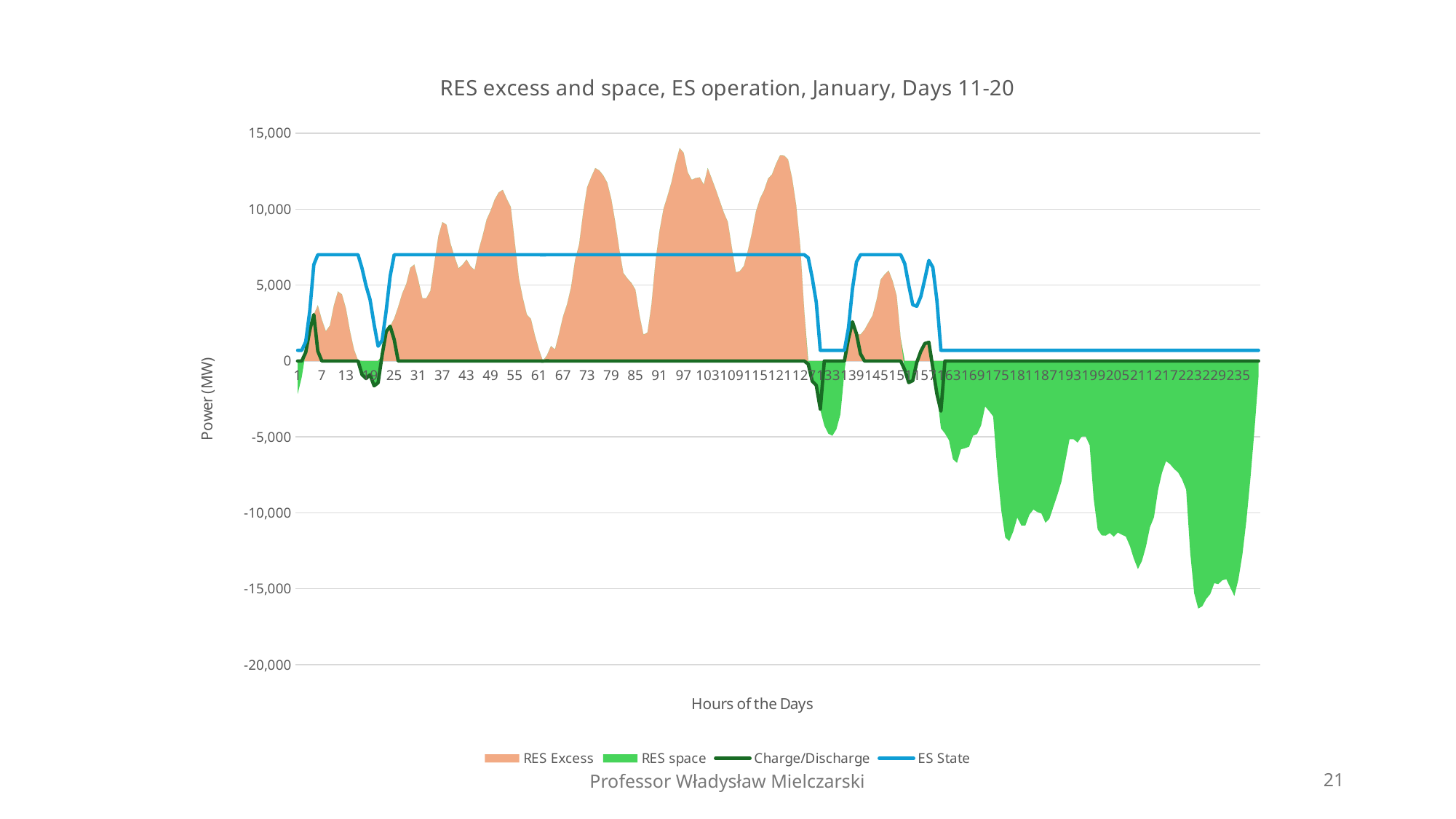
Is the lowest value of the RES space series greater or less than -15,000? less What is the title of the chart? RES excess and space, ES operation, January, Days 11-20 Is the peak value of the RES Excess series greater or less than 10,000? greater What is the title of the horizontal axis? Hours of the Days Which series is plotted as a blue line? ES State How many series does the chart legend list? 4 What are the series names listed in the chart legend? RES Excess, RES space, Charge/Discharge, ES State What is the lowest value shown on the vertical axis? -20,000 What is the title of the vertical axis? Power (MW) What is the highest value shown on the vertical axis? 15,000 Which series has the larger peak value: RES Excess or Charge/Discharge? RES Excess Is the plateau level of the ES State series greater or less than 5,000? greater